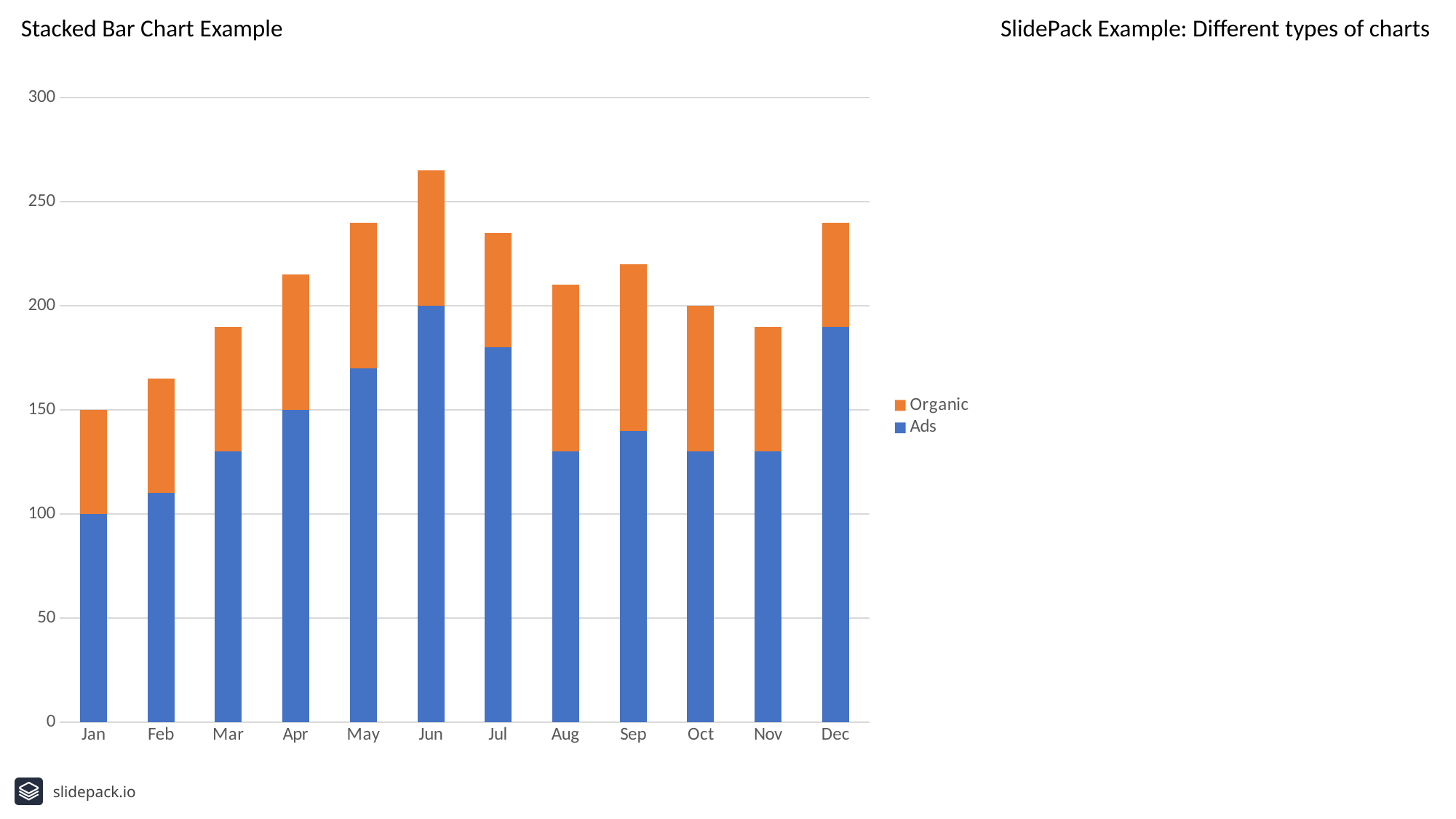
Which is larger, the total bar for Jun or the total bar for Jul? Jun What type of chart is shown on the slide? Stacked bar chart Which colour represents the Organic series in the legend? Orange Which month has the highest total bar? Jun What is the Ads value for Jan? 100 How many series does the legend list? 2 Which month has the lowest total bar? Jan Is the Ads value for Dec greater or less than 150? greater What is the Ads value for Jun? 200 How many months are shown on the x axis? 12 What is the total of the stacked bar for Oct? 200 Is the total for Jun greater or less than 250? greater